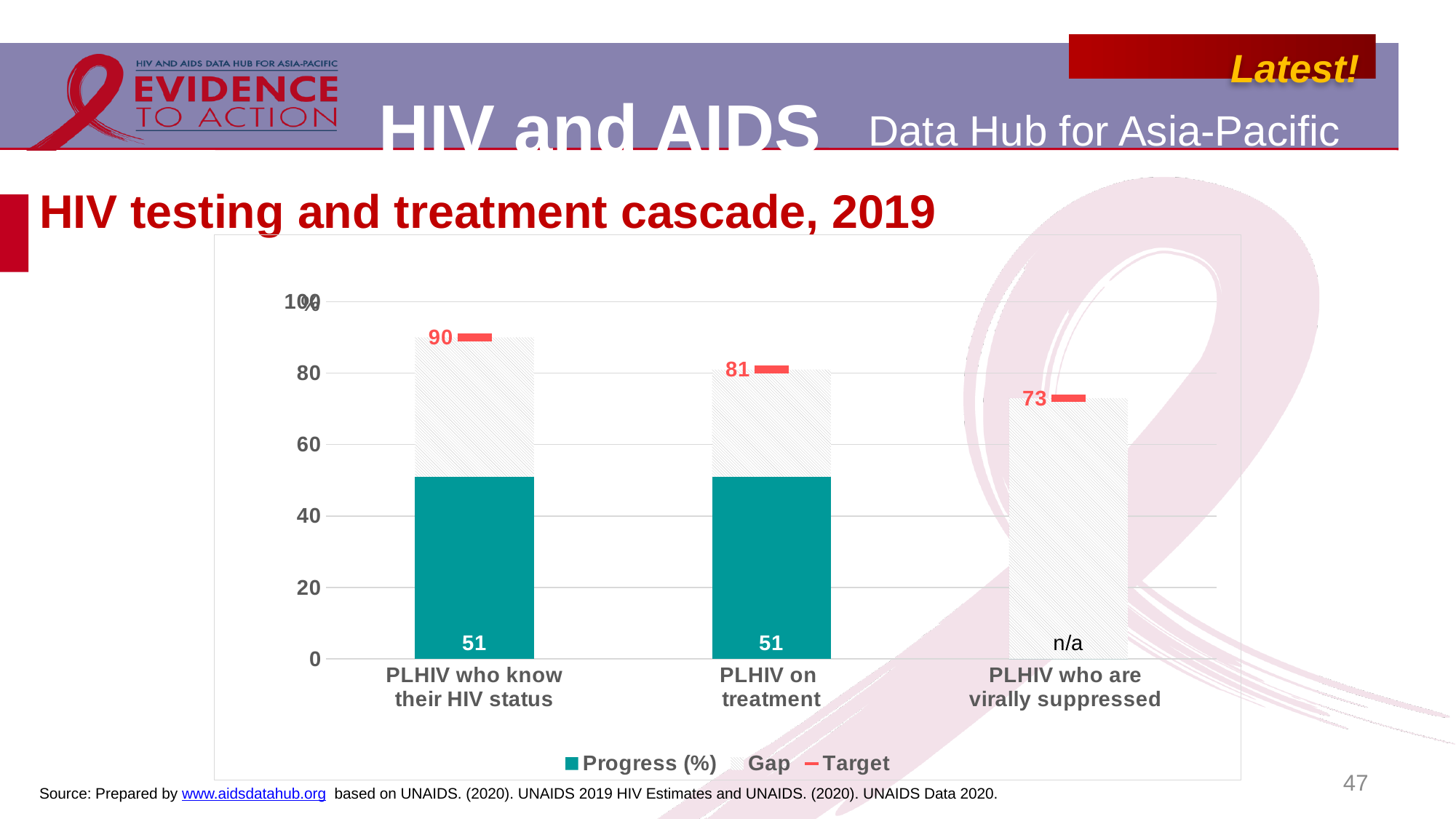
Which category has the lowest Target value? PLHIV who are virally suppressed What is the Progress (%) value for PLHIV on treatment? 51 What is the Progress (%) value for PLHIV who know their HIV status? 51 What is the difference between the Target and the Progress (%) for PLHIV who know their HIV status? 39 What is the Target value for PLHIV who know their HIV status? 90 What is the title of the chart? HIV testing and treatment cascade, 2019 Which category has the highest Target value? PLHIV who know their HIV status What is the Target value for PLHIV who are virally suppressed? 73 How many series does the legend list? 3 Is the Target value for PLHIV on treatment greater or less than 80? greater What is the Target value for PLHIV on treatment? 81 What is the Progress (%) value shown for PLHIV who are virally suppressed? n/a